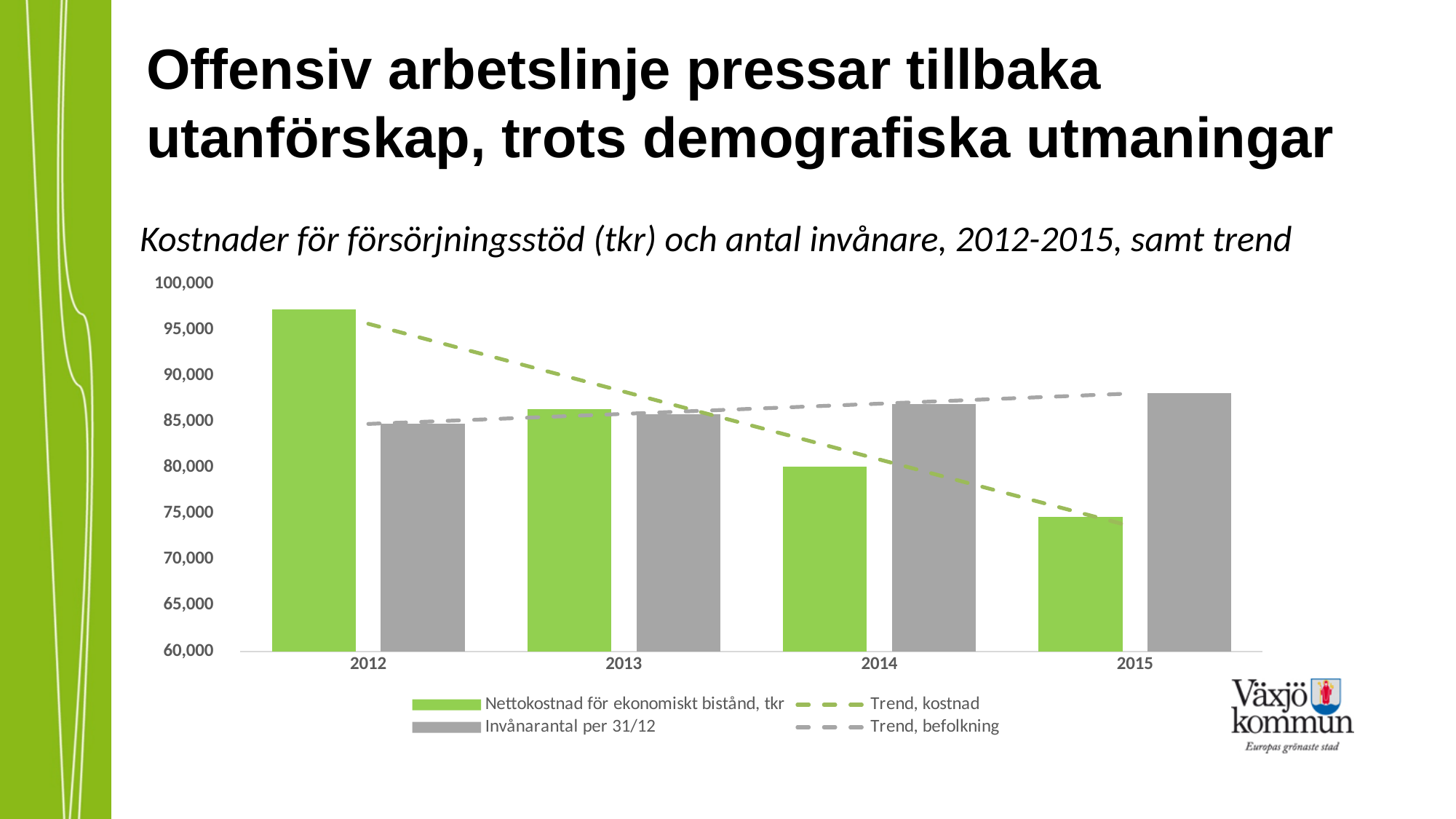
Is the value for Nettokostnad för ekonomiskt bistånd, tkr in 2015 greater or less than 80,000? less How many years are shown on the x axis of the chart? 4 What kind of chart is shown on the slide? Bar chart In which year is the value for Nettokostnad för ekonomiskt bistånd, tkr lowest? 2015 Is the value for Nettokostnad för ekonomiskt bistånd, tkr in 2012 greater or less than 95,000? greater In which year is the value for Nettokostnad för ekonomiskt bistånd, tkr highest? 2012 In 2012, which is larger: Nettokostnad för ekonomiskt bistånd, tkr or Invånarantal per 31/12? Nettokostnad för ekonomiskt bistånd, tkr In 2015, which is larger: Nettokostnad för ekonomiskt bistånd, tkr or Invånarantal per 31/12? Invånarantal per 31/12 How many entries does the chart's legend list? 4 What is the title of the chart? Kostnader för försörjningsstöd (tkr) och antal invånare, 2012-2015, samt trend Is the value for Invånarantal per 31/12 in 2015 greater or less than 85,000? greater Do the values for Nettokostnad för ekonomiskt bistånd, tkr rise or fall from 2012 to 2015? Fall